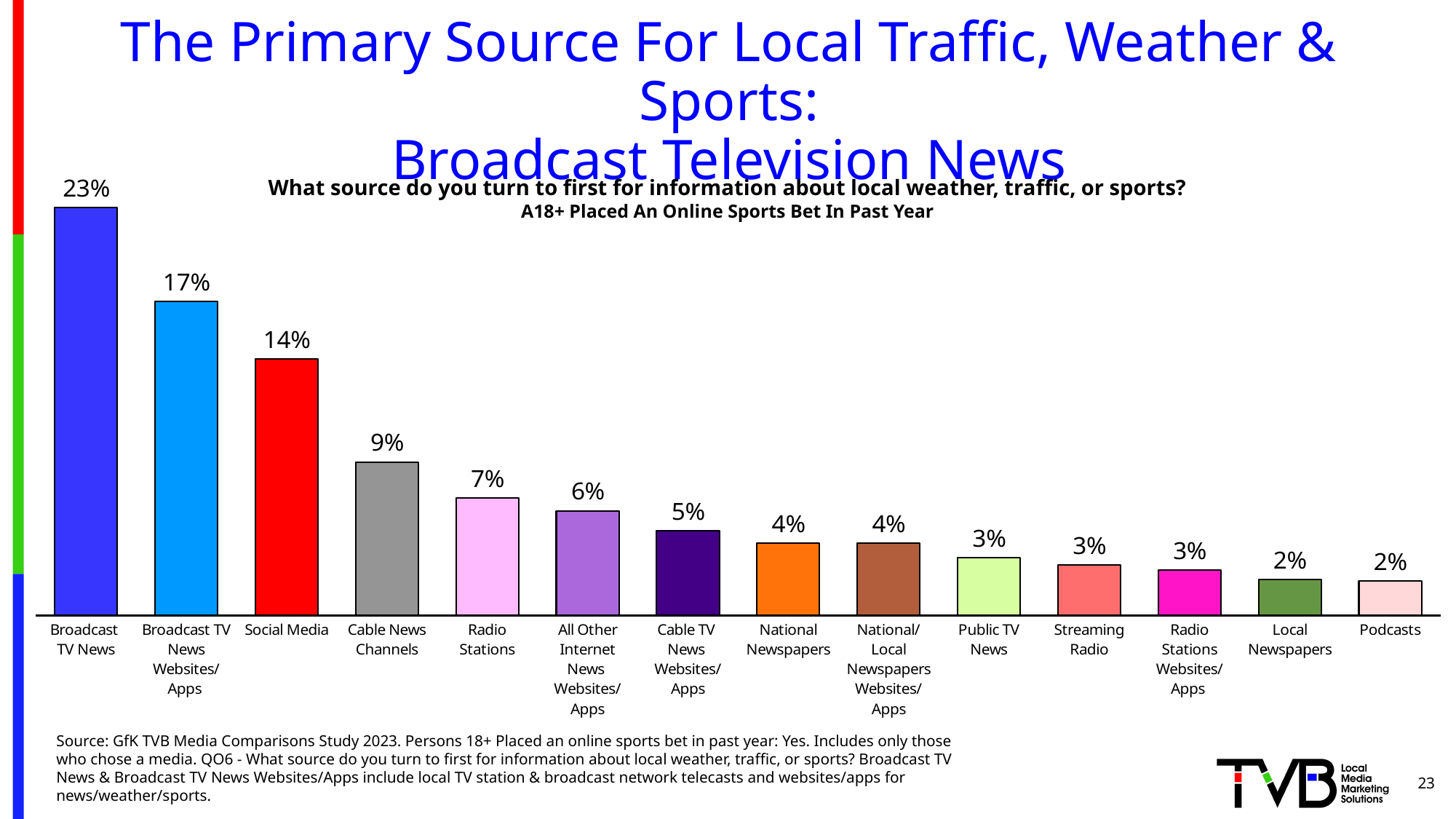
What percentage is shown for Broadcast TV News? 23% Which source has the highest value? Broadcast TV News What percentage is shown for Cable News Channels? 9% What kind of chart is shown on the slide? Bar chart What is the value for Public TV News? 3% What is the difference between Broadcast TV News and Broadcast TV News Websites/Apps? 6% What is the difference between Social Media and Radio Stations? 7% What is the value for Social Media? 14% Which is larger, Cable TV News Websites/Apps or National Newspapers? Cable TV News Websites/Apps Do the values rise or fall from left to right across the chart? Fall How many sources are shown in the chart? 14 Which is larger, Radio Stations or All Other Internet News Websites/Apps? Radio Stations